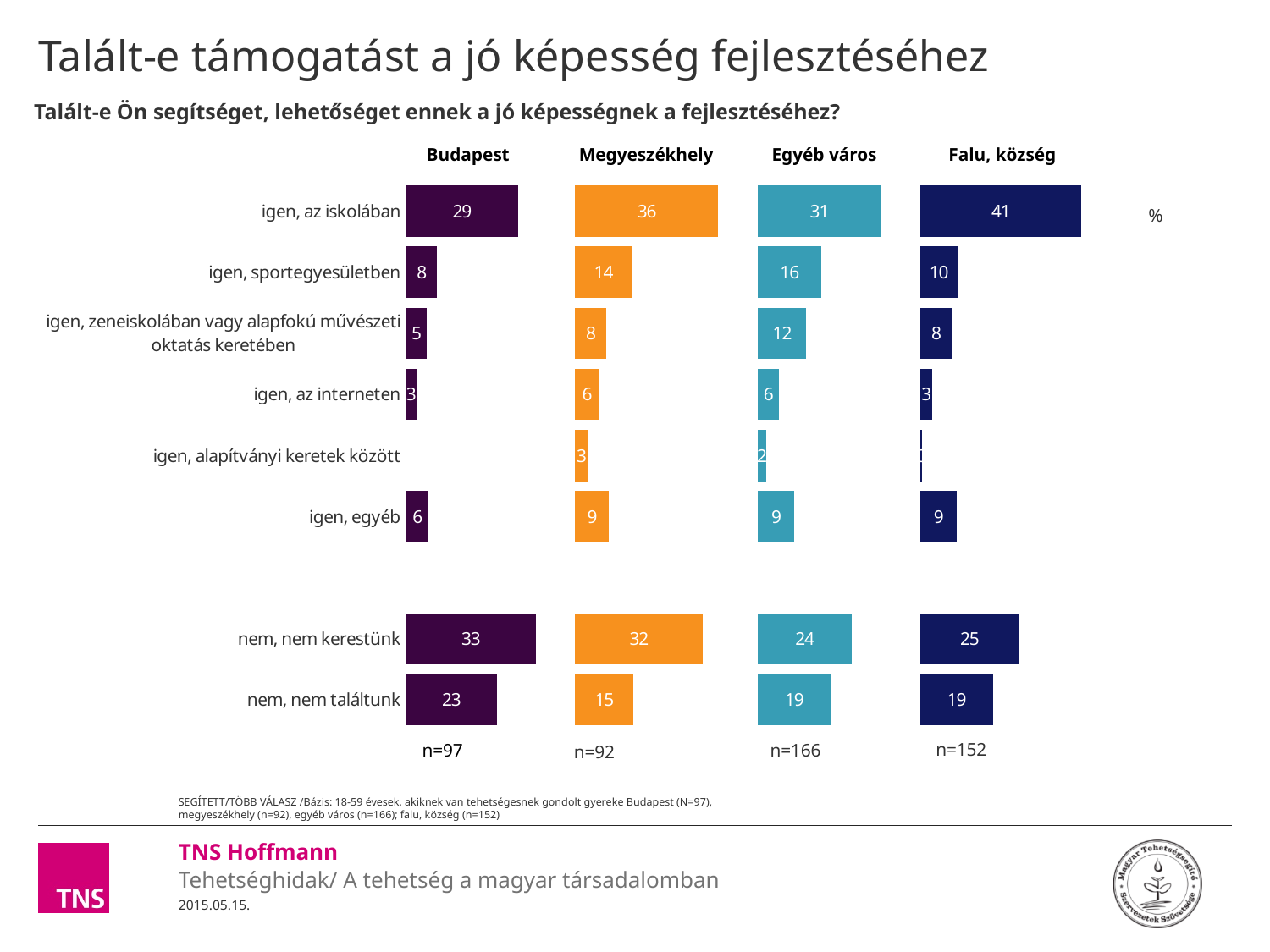
What kind of chart is used on this slide? bar chart In the Falu, község chart, what is the value for "igen, az iskolában"? 41 In the Megyeszékhely chart, which category has the lowest value? igen, alapítványi keretek között Across the four charts, which chart has the highest value for "igen, az iskolában"? Falu, község In the Budapest chart, what is the value for "igen, az iskolában"? 29 In the Falu, község chart, what is the difference between "igen, az iskolában" and "nem, nem kerestünk"? 16 In the Egyéb város chart, which is larger: "nem, nem kerestünk" or "nem, nem találtunk"? nem, nem kerestünk How many categories are shown in each chart? 8 In the Budapest chart, which category has the highest value? nem, nem kerestünk In the Megyeszékhely chart, what is the value for "nem, nem találtunk"? 15 In the Egyéb város chart, what is the value for "igen, sportegyesületben"? 16 What is the sample size (n) shown under the Egyéb város chart? n=166